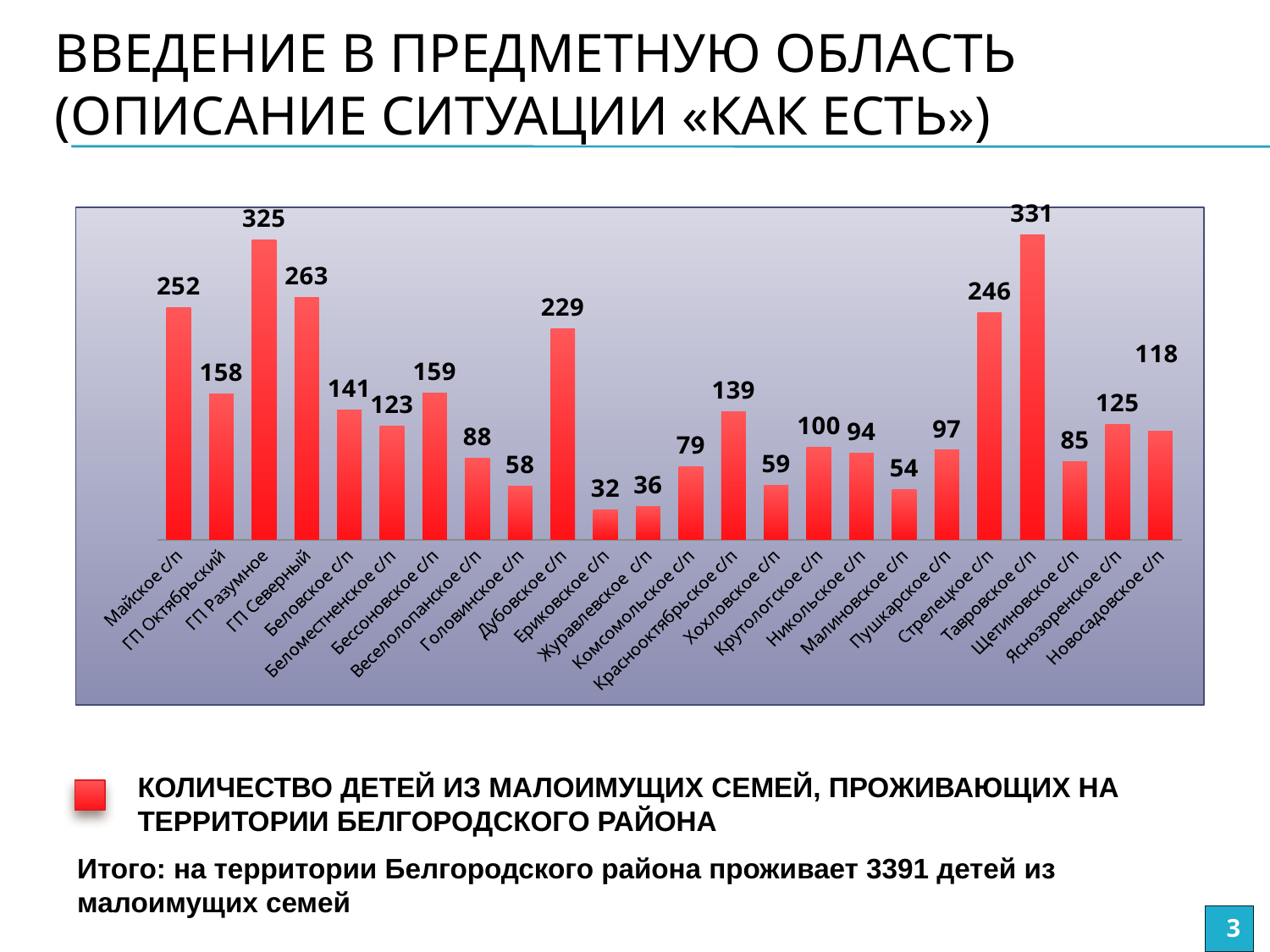
Which category has the highest value? Тавровское с/п Which category has the lowest value? Ериковское с/п What is the value for Майское с/п? 252 What is the difference between the values for Стрелецкое с/п and Щетиновское с/п? 161 How many categories are shown on the x axis? 24 What is the difference between the values for ГП Разумное and ГП Северный? 62 What is the value for Крутологское с/п? 100 What is the value for Дубовское с/п? 229 How many series does the legend list? 1 Which is larger, the value for Беловское с/п or the value for Бессоновское с/п? Бессоновское с/п Which is larger, the value for Яснозоренское с/п or the value for Новосадовское с/п? Яснозоренское с/п What kind of chart is shown on the slide? bar chart